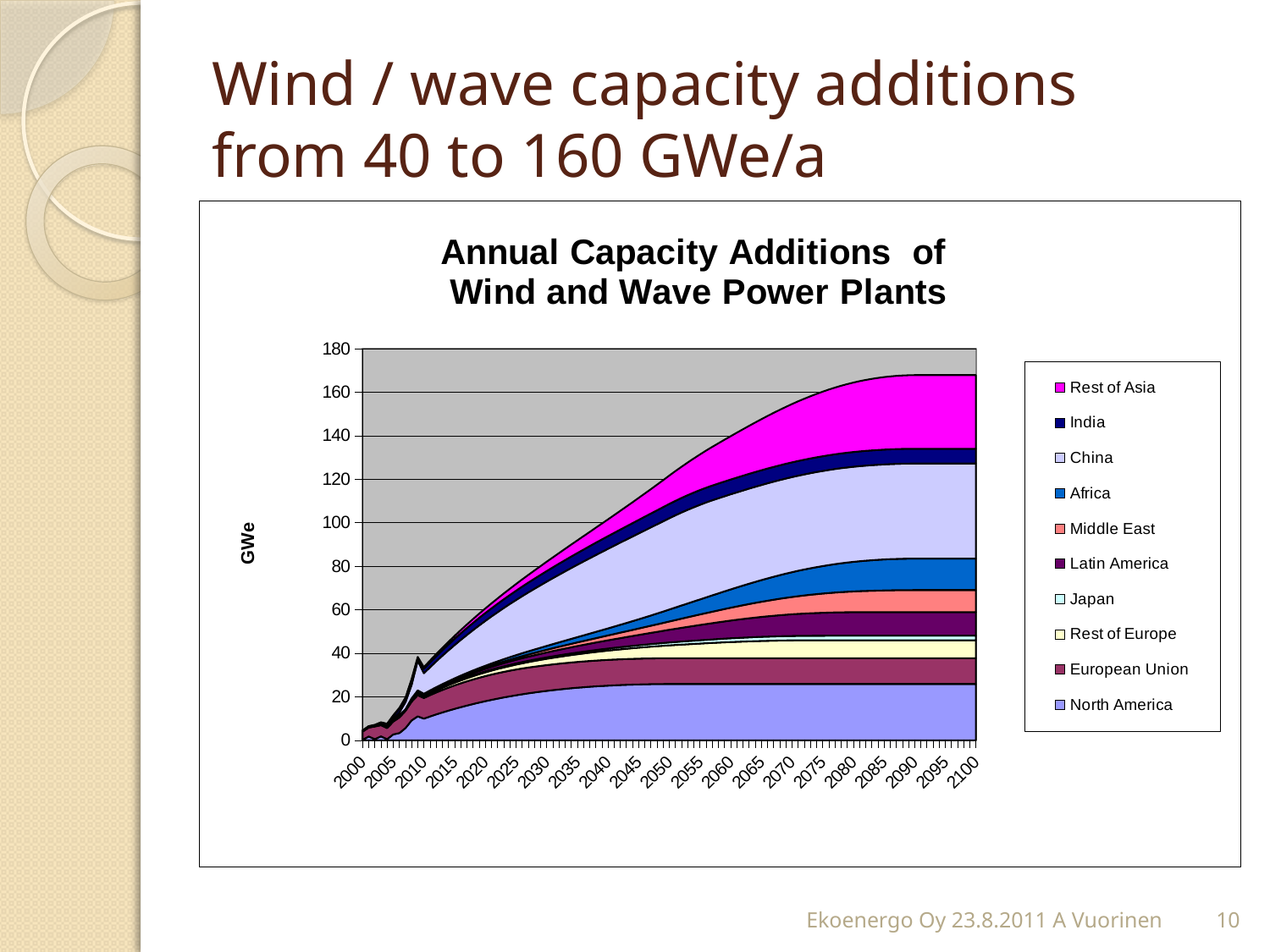
What is the label on the vertical axis? GWe Which series contributes the largest amount in 2100? China How many series does the legend list? 10 Which series contributes the smallest amount in 2100? Japan Does the total annual capacity addition rise or fall from 2000 to 2100? Rise How many year labels are shown on the x axis? 21 In 2100, which contributes more: Rest of Asia or India? Rest of Asia What is the title of the chart? Annual Capacity Additions of Wind and Wave Power Plants Is the total stacked value in 2000 greater or less than 20? less Is the total stacked value in 2030 greater or less than 60? greater Is the total stacked value in 2100 greater or less than 160? greater What kind of chart is shown on the slide? Stacked area chart